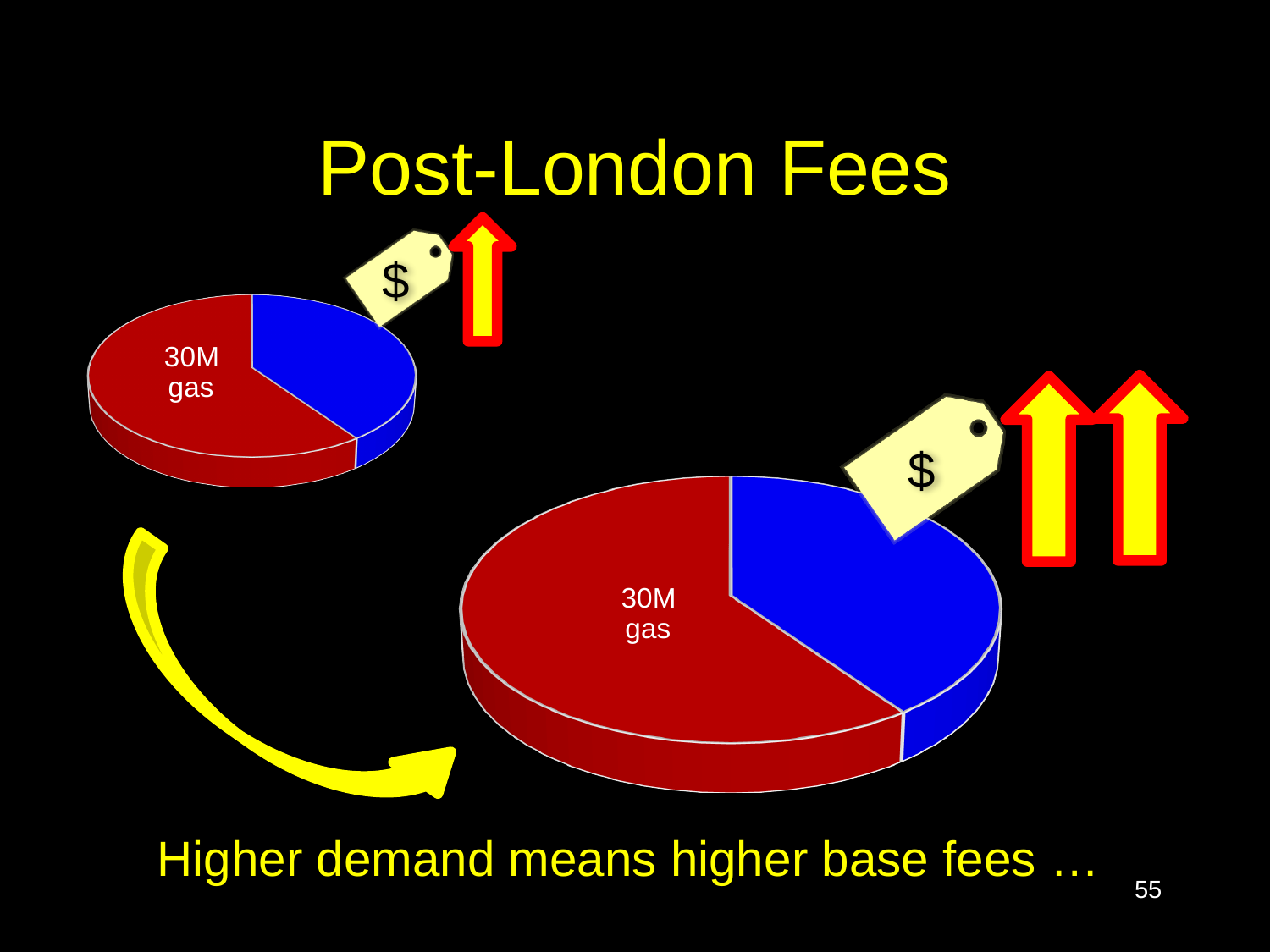
In the smaller pie chart on the left, which slice is larger, the red one or the blue one? red What colour is the slice labelled "30M gas" in the pie charts? red How many pie charts are on the slide? 2 What kind of chart is shown on the right side of the slide? pie chart What label is printed on the red slice of the smaller pie chart on the left? 30M gas What label is printed on the red slice of the larger pie chart on the right? 30M gas How many slices does the smaller pie chart on the left have? 2 What kind of chart is shown on the left side of the slide? pie chart What is the title of the slide containing the pie charts? Post-London Fees How many slices does the larger pie chart on the right have? 2 In the larger pie chart on the right, which slice is larger, the red one or the blue one? red